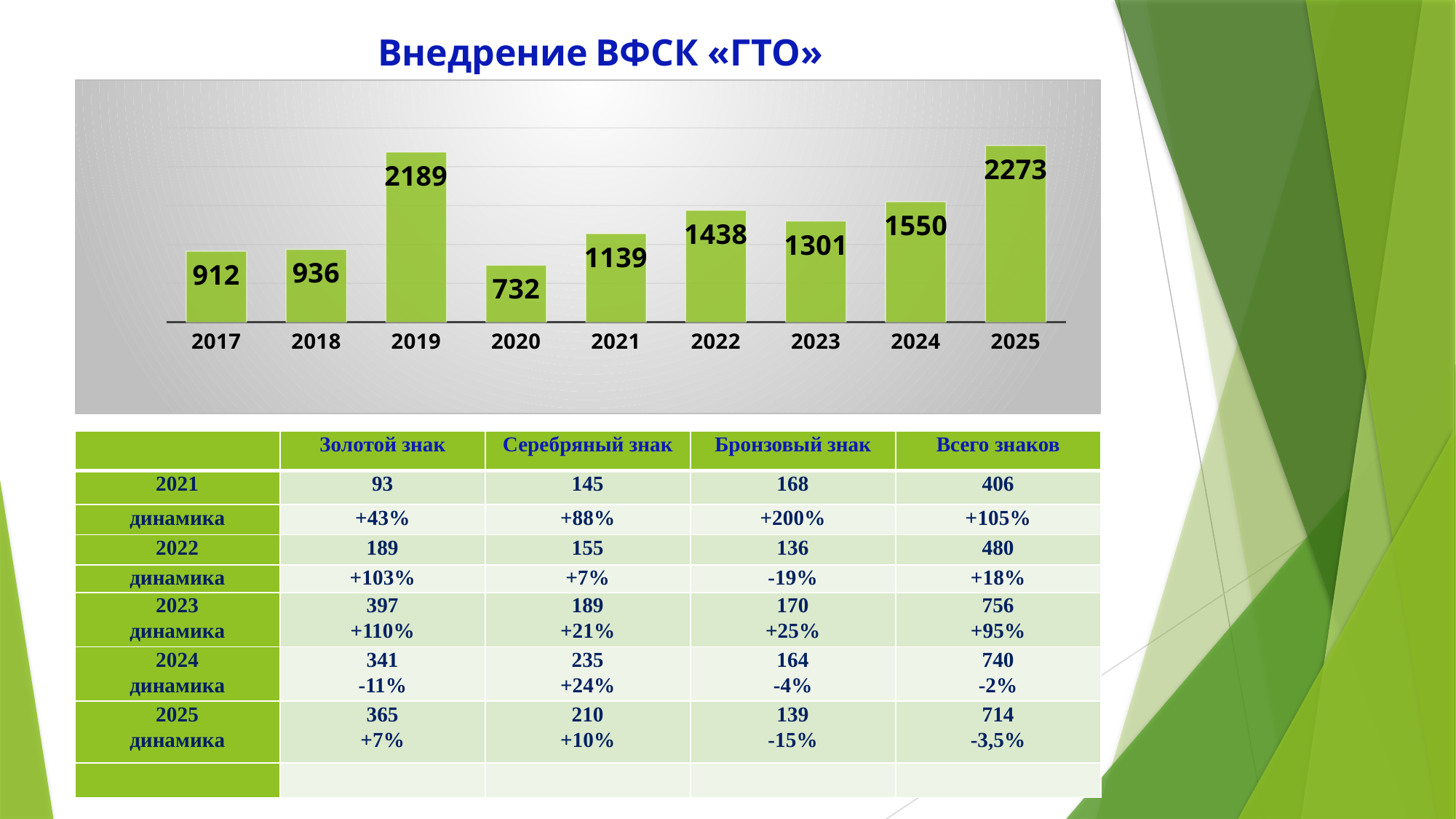
What is the title of the slide containing the bar chart? Внедрение ВФСК «ГТО» How many years are shown on the x axis of the bar chart? 9 What is the difference between the values for 2022 and 2023 in the bar chart? 137 What is the value for 2024 in the bar chart? 1550 Which year has the lowest value in the bar chart? 2020 What is the difference between the values for 2025 and 2024 in the bar chart? 723 What kind of chart is shown on the slide? bar chart What is the value for 2020 in the bar chart? 732 What is the value for 2019 in the bar chart? 2189 Do the values in the bar chart rise or fall from 2020 to 2022? rise Which year has the highest value in the bar chart? 2025 Which is larger in the bar chart, the value for 2021 or the value for 2022? 2022